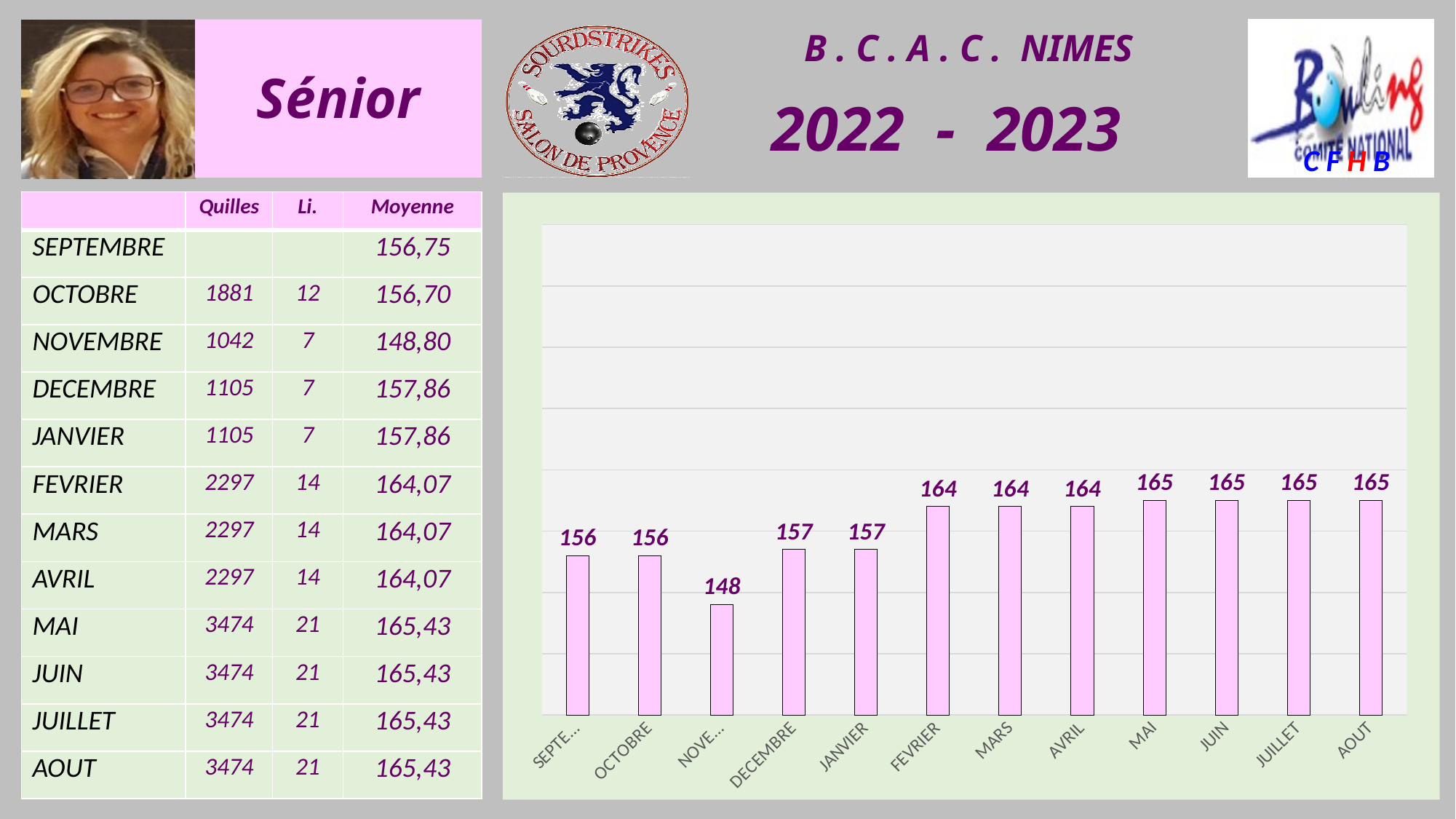
What is the value shown for AOUT in the bar chart? 165 Which is larger in the bar chart, the value for JANVIER or the value for MARS? MARS What is the value shown for OCTOBRE in the bar chart? 156 How many bars are plotted in the chart? 12 What type of chart is shown on the right of the slide? Bar chart What is the value shown for DECEMBRE in the bar chart? 157 Which month has the lowest bar in the chart? NOVEMBRE Do the values in the bar chart generally rise or fall from left to right? Rise What is the difference between the values for FEVRIER and the third bar (NOVE...) in the chart? 16 What is the value of the lowest bar in the chart? 148 What is the value shown for FEVRIER in the bar chart? 164 What is the difference between the values for AOUT and DECEMBRE in the bar chart? 8